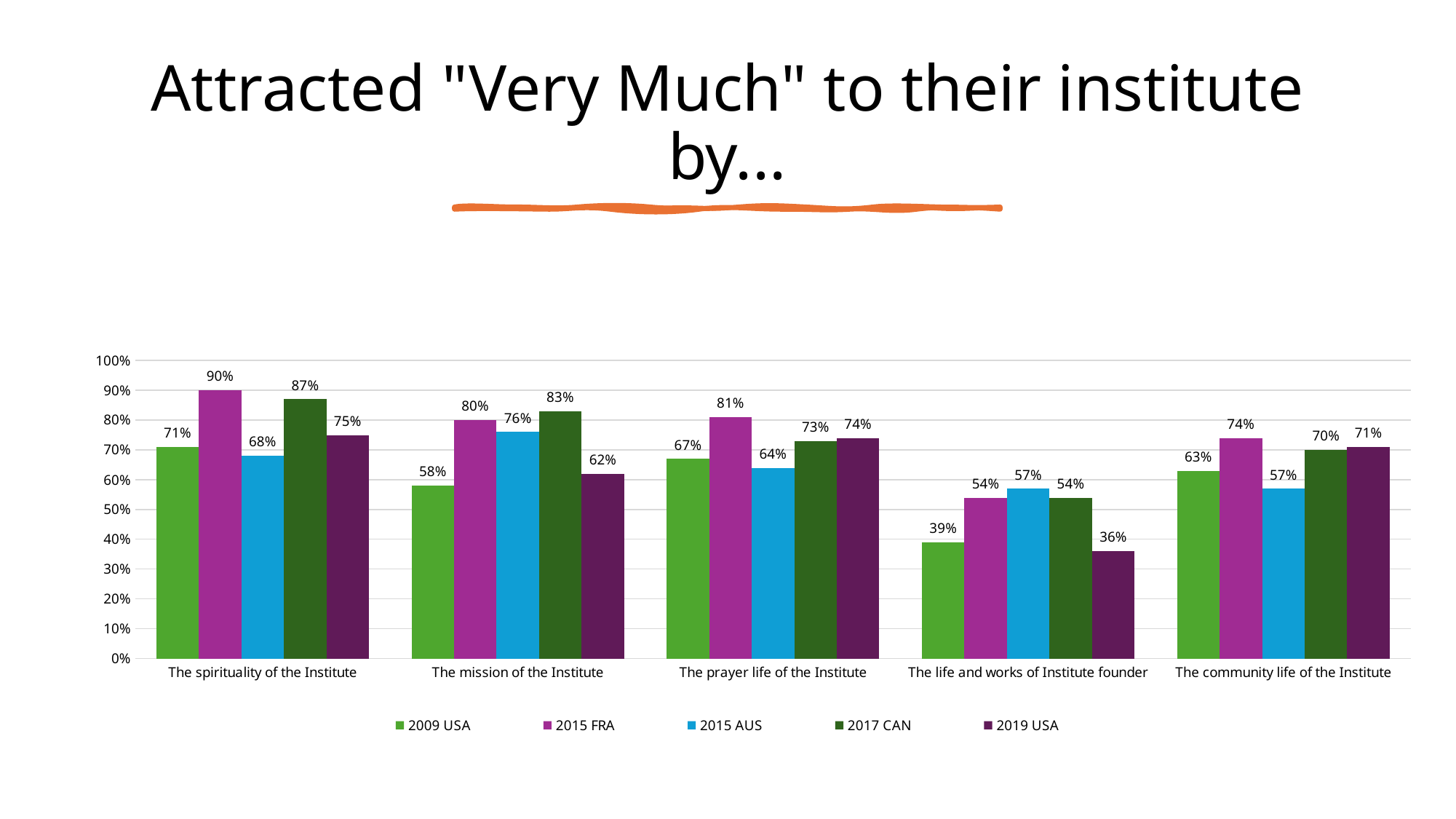
What is the title of the slide? Attracted "Very Much" to their institute by... Which category has the highest value for 2017 CAN? The spirituality of the Institute Which is larger for The prayer life of the Institute: 2017 CAN or 2015 AUS? 2017 CAN What is the value for 2019 USA for The life and works of Institute founder? 36% How many series does the legend list? 5 Which series is shown in blue in the legend? 2015 AUS How many categories are shown on the x axis? 5 What is the value for 2015 FRA for The spirituality of the Institute? 90% What is the difference between the 2015 FRA and 2009 USA values for The mission of the Institute? 22% Which category has the lowest value for 2009 USA? The life and works of Institute founder What is the value for 2015 AUS for The mission of the Institute? 76% What kind of chart is shown on the slide? Bar chart